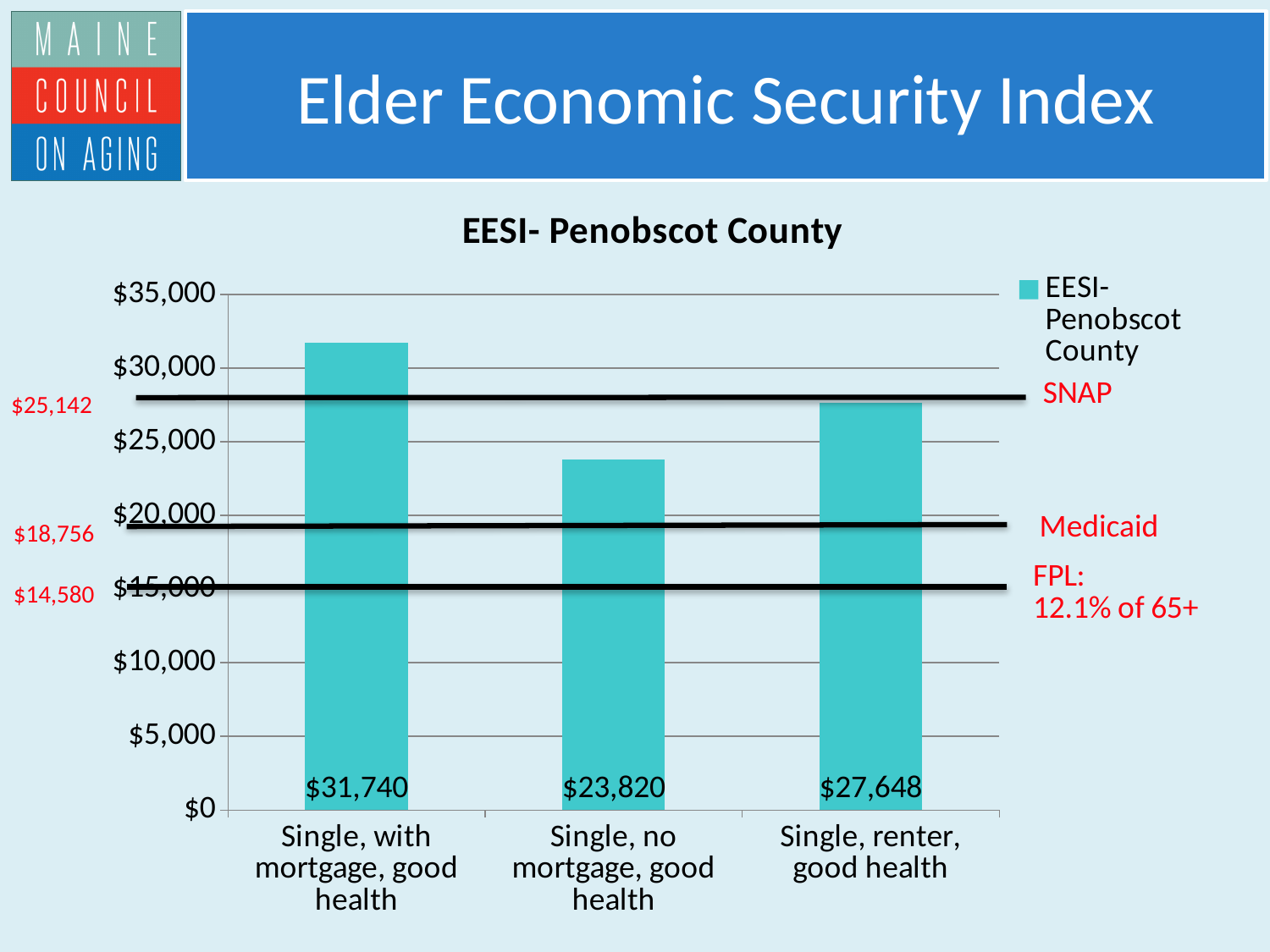
What kind of chart is shown on the slide? bar chart Which category has the lowest EESI value? Single, no mortgage, good health What is the EESI value for 'Single, no mortgage, good health'? $23,820 What is the difference between the EESI values for 'Single, with mortgage, good health' and 'Single, no mortgage, good health'? $7,920 Which is larger: the EESI value for 'Single, renter, good health' or for 'Single, no mortgage, good health'? Single, renter, good health What is the title of the chart? EESI- Penobscot County Which category has the highest EESI value? Single, with mortgage, good health What is the EESI value for 'Single, with mortgage, good health'? $31,740 What is the difference between the EESI values for 'Single, renter, good health' and 'Single, no mortgage, good health'? $3,828 Is the value for 'Single, no mortgage, good health' greater or less than $25,000? less How many categories are shown on the x axis? 3 What is the EESI value for 'Single, renter, good health'? $27,648